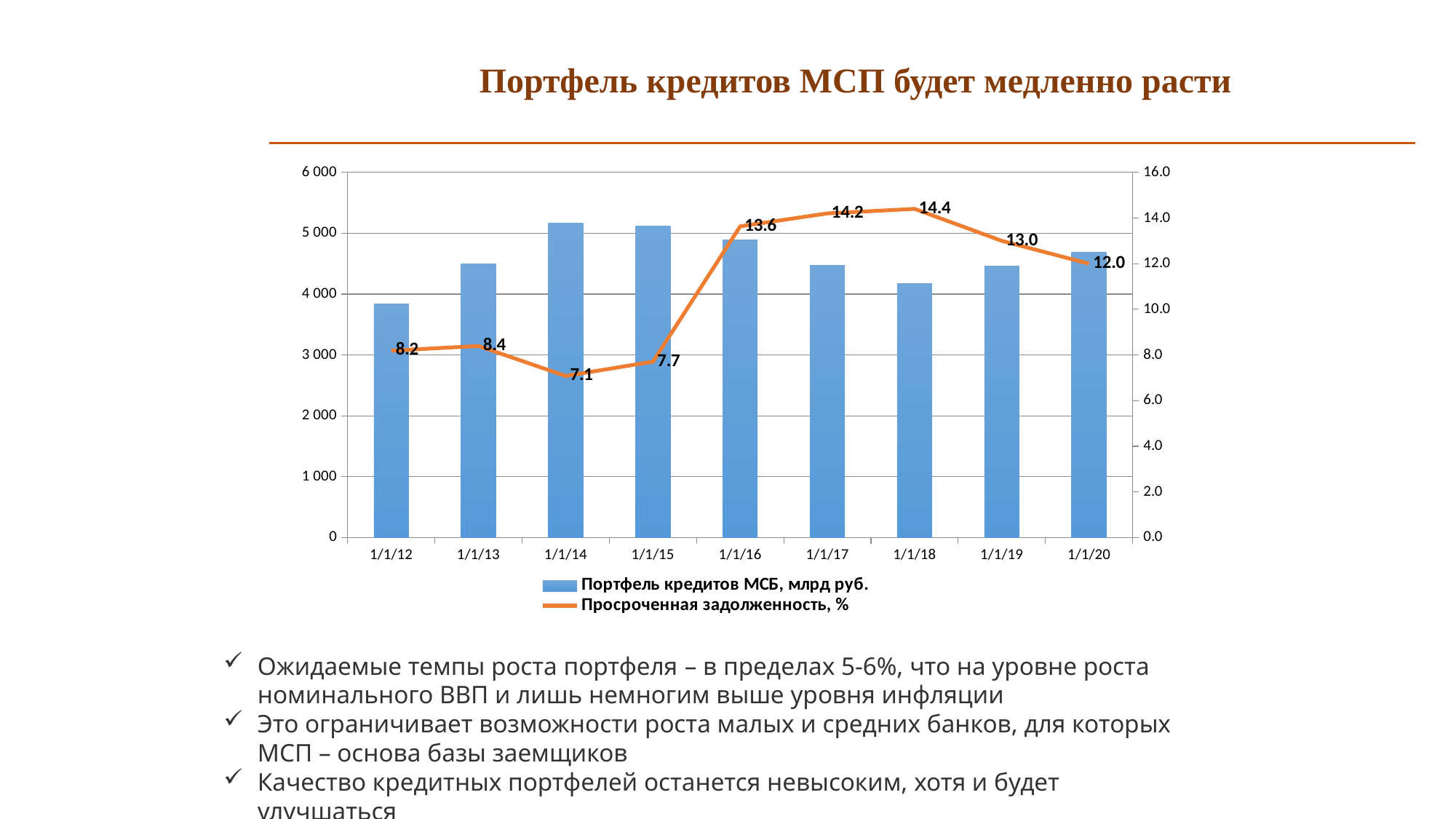
How many dates are shown on the x axis of the chart? 9 At which date is the overdue debt (Просроченная задолженность, %) highest? 1/1/18 What is the overdue debt (Просроченная задолженность, %) value at 1/1/20? 12.0 Which date has the lowest loan portfolio (Портфель кредитов МСБ, млрд руб.) bar? 1/1/12 Is the loan portfolio (Портфель кредитов МСБ, млрд руб.) bar for 1/1/14 greater or less than 5 000? greater Which is larger: the overdue debt at 1/1/13 or at 1/1/19? 1/1/19 How many series does the chart legend list? 2 What is the overdue debt (Просроченная задолженность, %) value at 1/1/14? 7.1 Is the loan portfolio (Портфель кредитов МСБ, млрд руб.) bar for 1/1/12 greater or less than 4 000? less What is the difference between the overdue debt values at 1/1/16 and 1/1/15? 5.9 At which date is the overdue debt (Просроченная задолженность, %) lowest? 1/1/14 What is the overdue debt (Просроченная задолженность, %) value at 1/1/18? 14.4